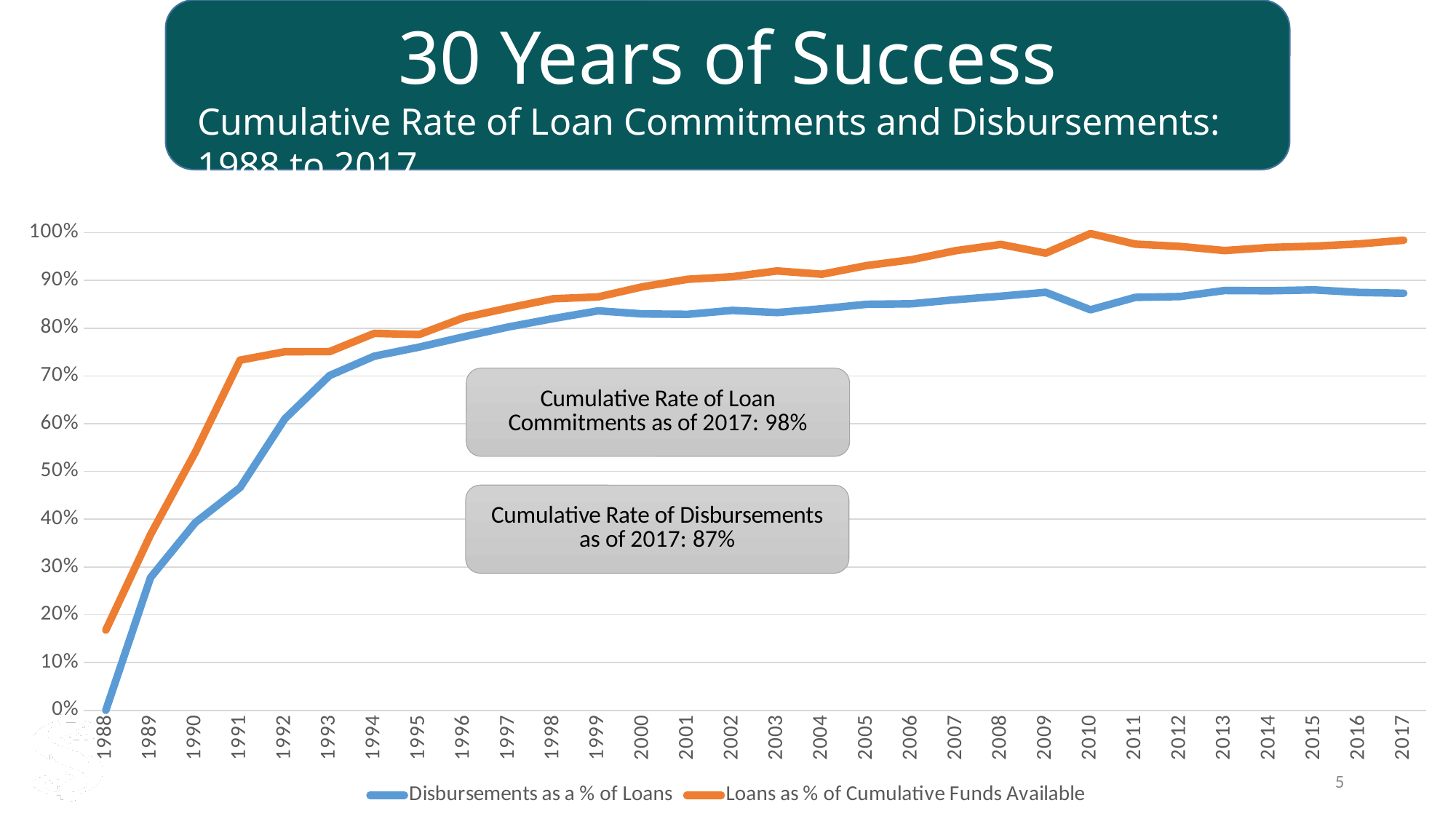
Is the value for Disbursements as a % of Loans in 1988 greater or less than 10%? less What is the difference between the cumulative rate of loan commitments and the cumulative rate of disbursements as of 2017? 11% What type of chart is shown on the slide? line chart Do the values for Loans as % of Cumulative Funds Available generally rise or fall from 1988 to 2017? rise How many series does the legend list? 2 Which series is higher in 2017, Disbursements as a % of Loans or Loans as % of Cumulative Funds Available? Loans as % of Cumulative Funds Available What is the cumulative rate of disbursements as of 2017? 87% How many years are plotted along the x axis? 30 Is the value for Loans as % of Cumulative Funds Available in 1991 greater or less than 70%? greater Is the value for Disbursements as a % of Loans in 1991 greater or less than 50%? less What is the cumulative rate of loan commitments as of 2017? 98% What colour is the line for Disbursements as a % of Loans? blue